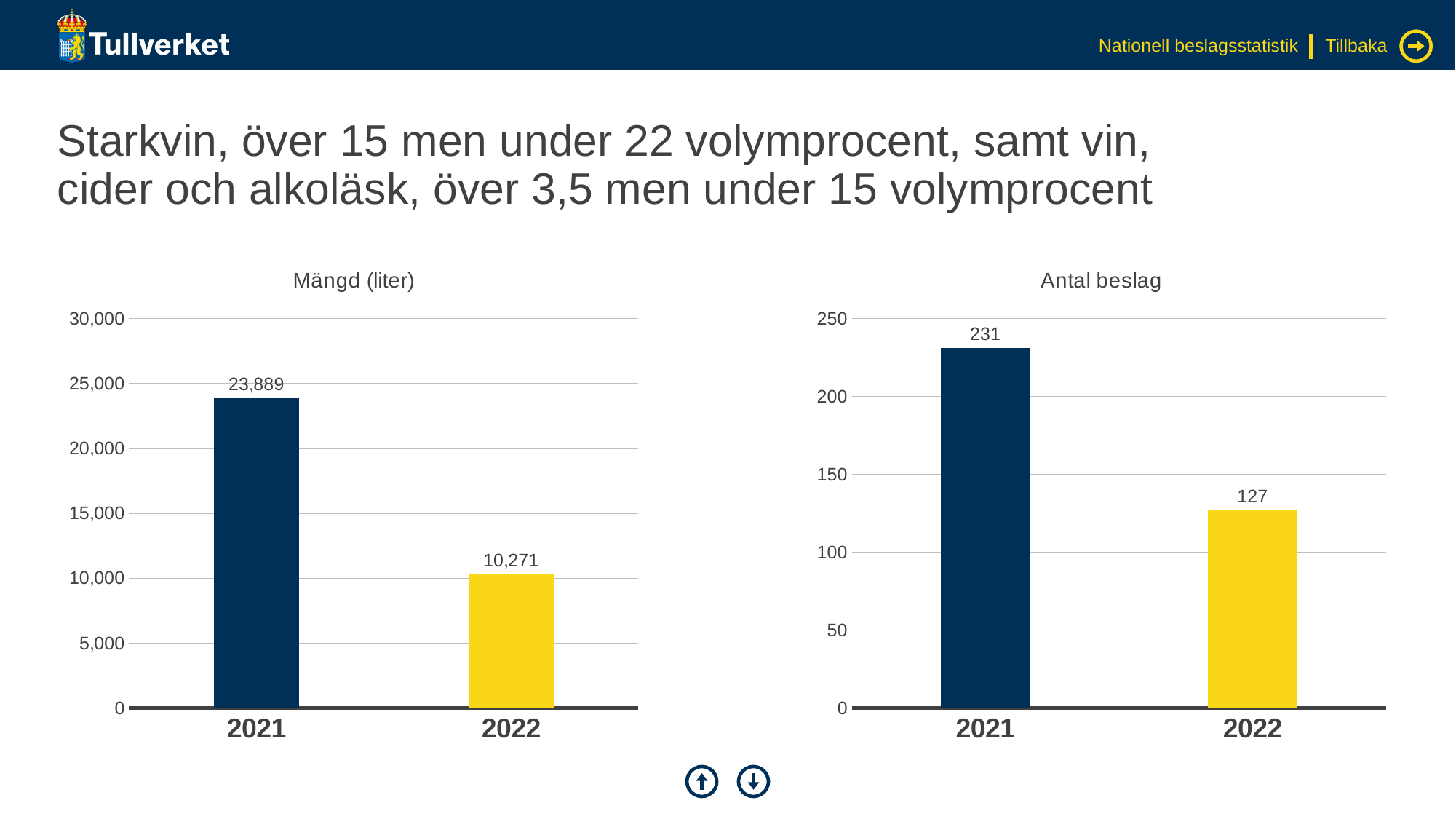
What kind of chart is the 'Antal beslag' chart? bar chart In the 'Mängd (liter)' chart, which year has the highest value? 2021 In the 'Antal beslag' chart, what is the value for 2021? 231 In the 'Antal beslag' chart, what is the value for 2022? 127 In the 'Mängd (liter)' chart, what is the value for 2021? 23,889 In the 'Antal beslag' chart, which year has the lowest value? 2022 In the 'Mängd (liter)' chart, what is the value for 2022? 10,271 In the 'Antal beslag' chart, is the value for 2021 greater or less than 200? greater In the 'Antal beslag' chart, what is the difference between the 2021 and 2022 values? 104 In the 'Mängd (liter)' chart, do the values rise or fall from 2021 to 2022? fall How many years are shown on the x axis of the 'Mängd (liter)' chart? 2 In the 'Mängd (liter)' chart, what is the difference between the 2021 and 2022 values? 13,618